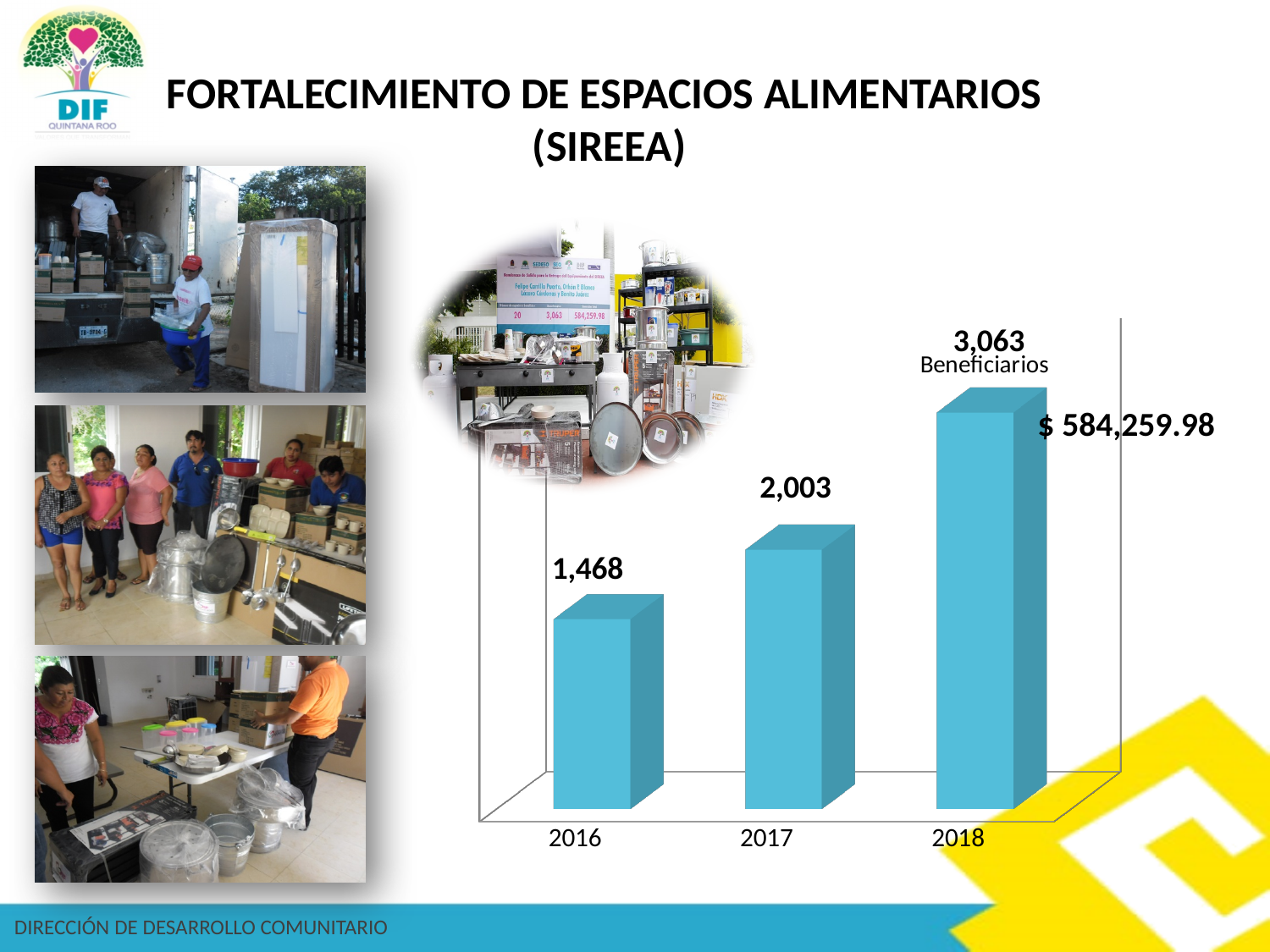
What is the value shown for 2017? 2,003 What is the difference between the values for 2017 and 2016? 535 How many years are shown on the x axis of the chart? 3 What kind of chart is shown on the slide? bar chart Which year has the highest bar? 2018 What monetary amount is printed next to the 2018 bar? $ 584,259.98 Do the values rise or fall from 2016 to 2018? rise Which is larger, the value for 2017 or the value for 2018? 2018 What is the difference between the values for 2018 and 2016? 1,595 What is the value shown for 2016? 1,468 Which year has the lowest bar? 2016 What is the value shown for 2018? 3,063